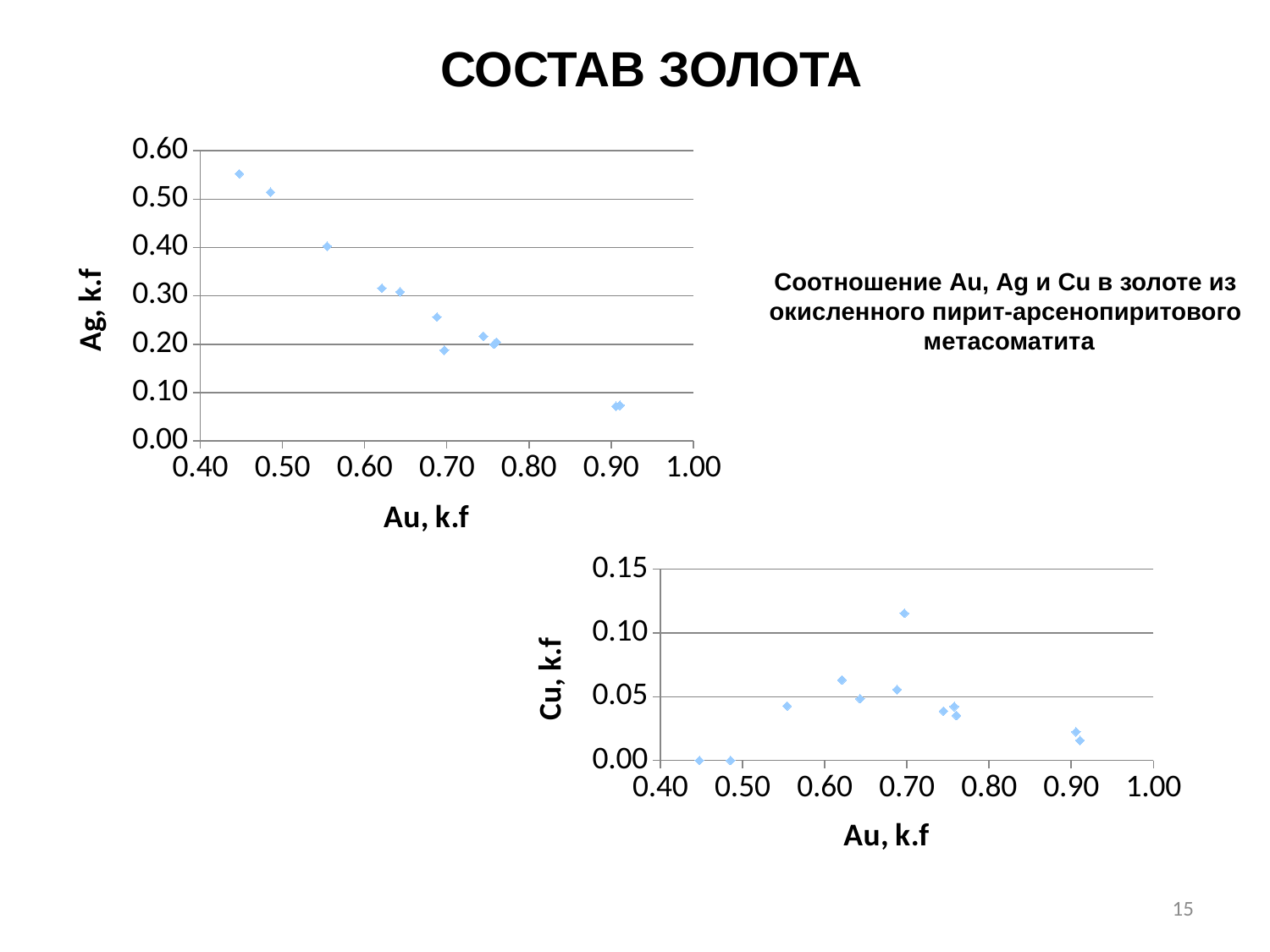
In the bottom chart (Cu, k.f vs Au, k.f), is the highest Cu value greater or less than 0.10? greater In the top chart (Ag, k.f vs Au, k.f), is the Ag value of the point near Au 0.55 greater or less than 0.50? less In the top chart (Ag, k.f vs Au, k.f), is the Ag value of the rightmost points (near Au 0.90) greater or less than 0.10? less What kind of chart is the top chart (Ag, k.f vs Au, k.f)? scatter chart In the top chart, which point has the higher Ag value: the one near Au 0.45 or the one near Au 0.90? the one near Au 0.45 What kind of chart is the bottom chart (Cu, k.f vs Au, k.f)? scatter chart What is the label of the horizontal axis of the top chart? Au, k.f What is the label of the vertical axis of the bottom chart? Cu, k.f In the top chart (Ag, k.f vs Au, k.f), do the Ag values rise or fall as Au increases along the x axis? fall